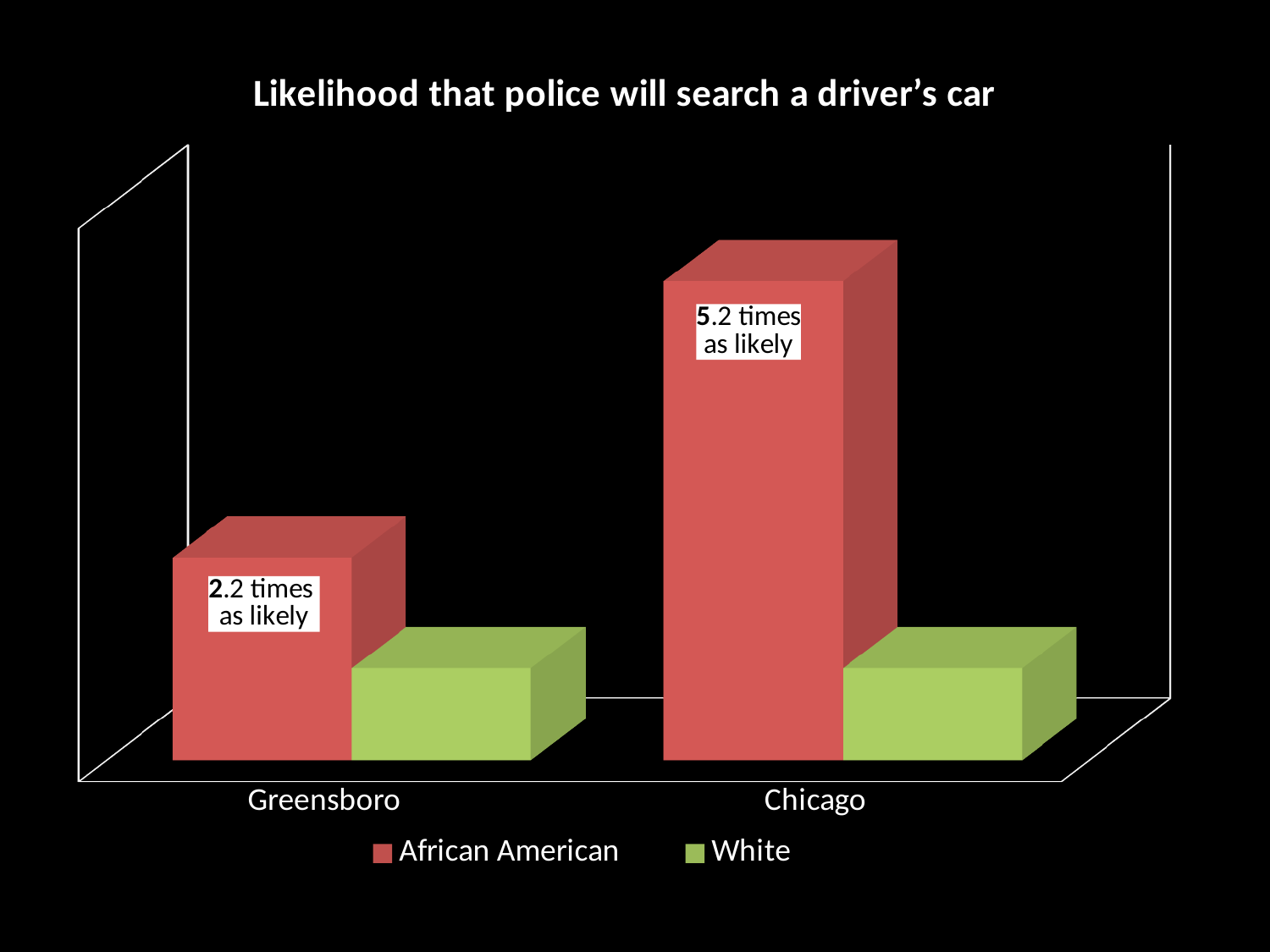
How many series does the legend list? 2 What kind of chart is shown on the slide? Bar chart What is the data label on the African American bar for Chicago? 5.2 times as likely What is the title of the chart? Likelihood that police will search a driver's car Which is larger: the African American value for Chicago or the African American value for Greensboro? Chicago In which city is the African American bar highest? Chicago In which city is the African American bar lowest? Greensboro By how many times does the African American value for Chicago exceed the African American value for Greensboro? 3 times Which colour represents the White series in the legend? Green How many cities are shown on the x axis? 2 In Greensboro, which bar is taller: African American or White? African American What is the data label on the African American bar for Greensboro? 2.2 times as likely